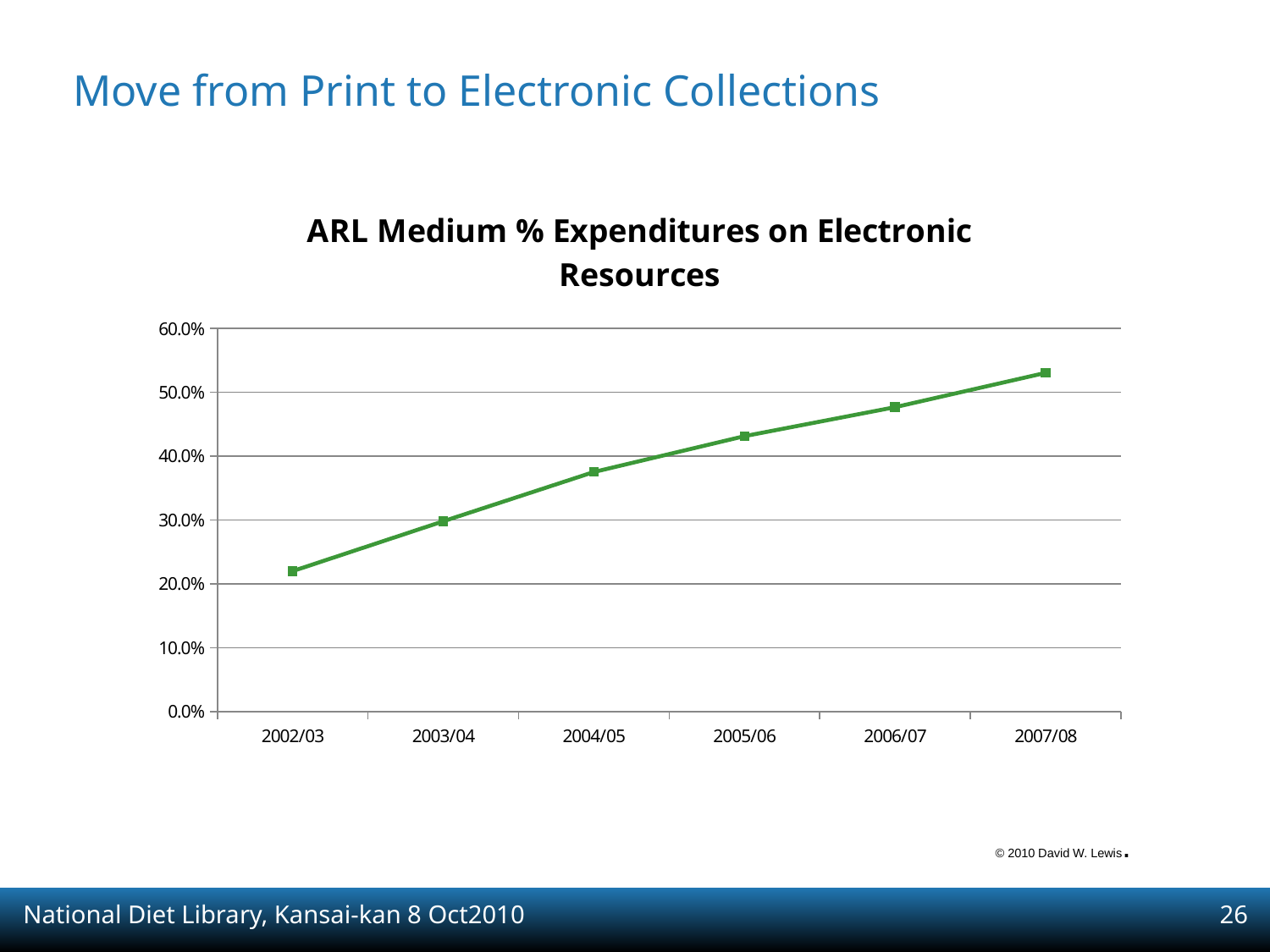
How many years are plotted on the x axis of the chart? 6 Is the value for 2007/08 greater or less than 50.0%? greater What kind of chart is shown on the slide? line chart Is the value for 2006/07 greater or less than 50.0%? less Is the value for 2005/06 greater or less than 40.0%? greater What is the title of the chart? ARL Medium % Expenditures on Electronic Resources Which is larger, the value for 2003/04 or the value for 2005/06? 2005/06 Which year has the lowest value on the chart? 2002/03 Which year has the highest value on the chart? 2007/08 Do the values rise or fall from 2002/03 to 2007/08? rise